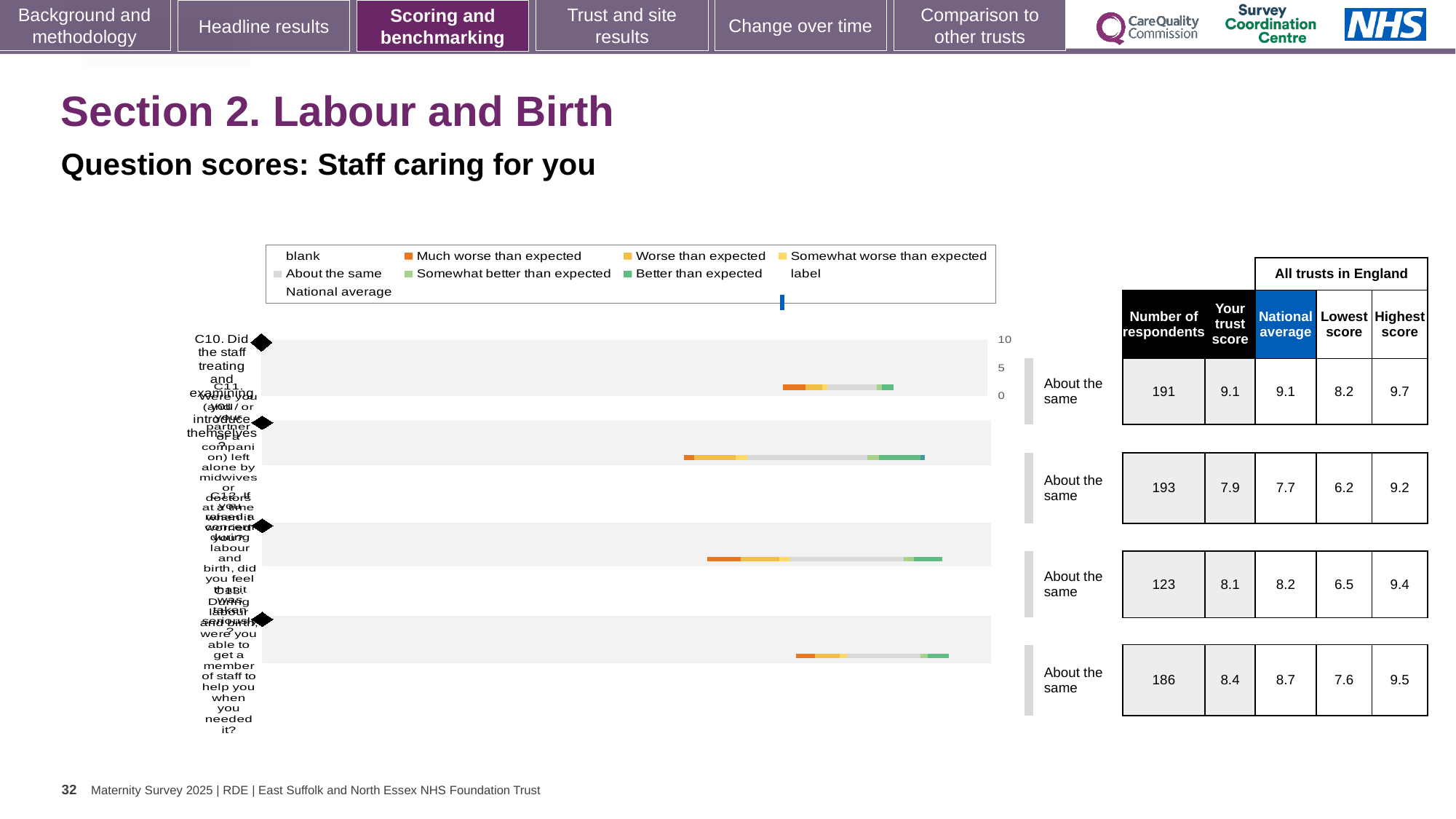
What is the number of respondents for the top question row (C10)? 191 Which question row has the highest number of respondents? C11 (193) What is the lowest score for the third question row (C12)? 6.5 For the top question row (C10), what is the difference between the highest score and the lowest score? 1.5 What is the subtitle describing the question scores on this slide? Question scores: Staff caring for you What is the 'Your trust score' value for the second question row (C11)? 7.9 What is the national average for the bottom question row (C13)? 8.7 For the third question row (C12), which is larger: the trust score or the national average? National average (8.2) Which question row has the lowest 'Your trust score'? C11 (7.9) How many question rows are plotted in the chart? 4 What benchmark category is shown next to each of the four question rows? About the same What kind of chart is shown on the slide? bar chart